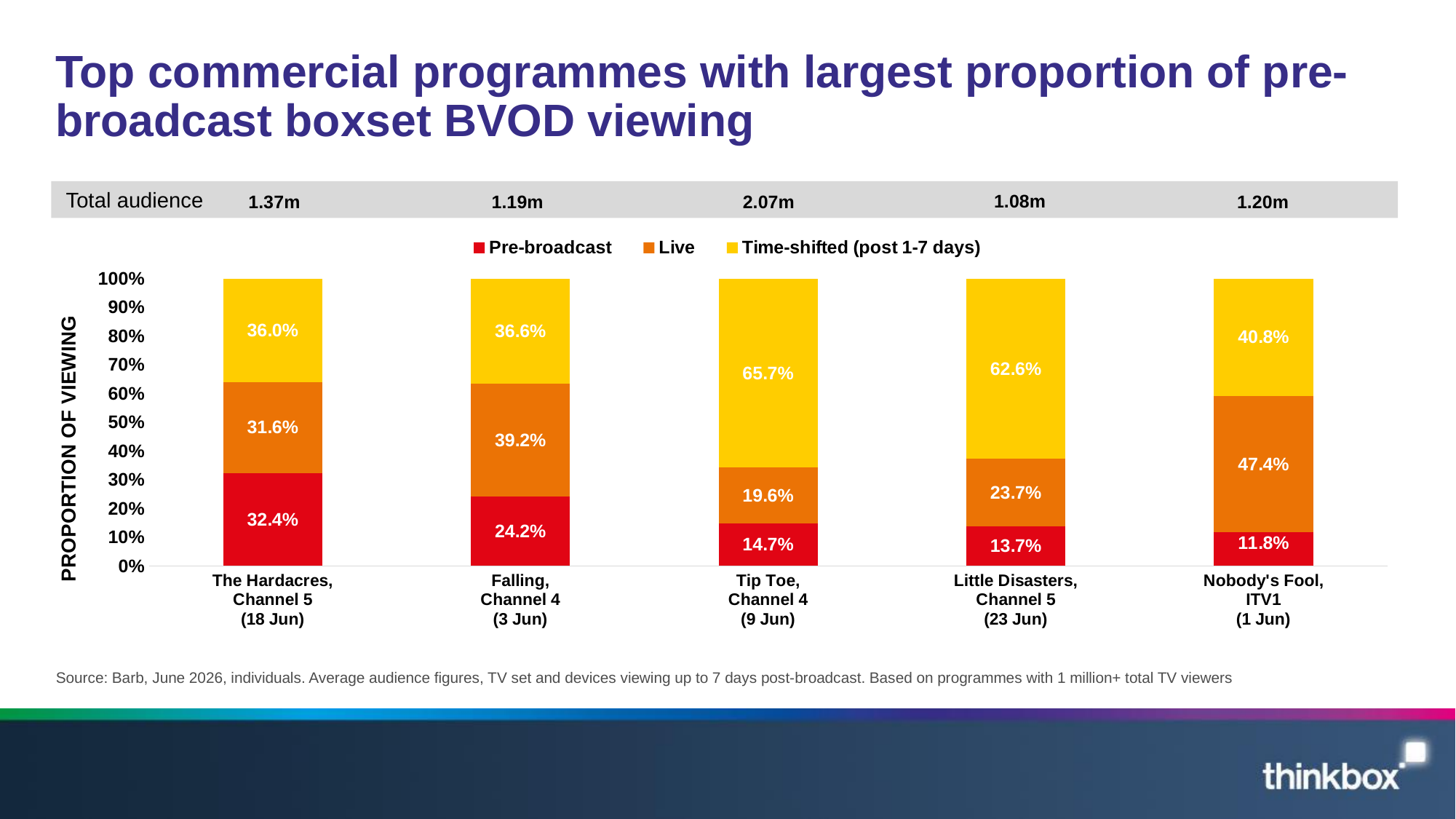
What is the difference between the Pre-broadcast shares of The Hardacres and Falling? 8.2% How many programmes are shown on the x axis? 5 What is the total audience shown for Tip Toe, Channel 4 (9 Jun)? 2.07m What is the Time-shifted (post 1-7 days) share of viewing for Tip Toe, Channel 4 (9 Jun)? 65.7% Which programme has the highest Live share of viewing? Nobody's Fool, ITV1 (1 Jun) What kind of chart is shown on the slide? Stacked bar chart Which programme has the lowest Pre-broadcast share of viewing? Nobody's Fool, ITV1 (1 Jun) How many series does the legend list? 3 Which is larger: the Time-shifted share for Tip Toe or for Little Disasters? Tip Toe What is the Live share of viewing for Nobody's Fool, ITV1 (1 Jun)? 47.4% What is the Pre-broadcast share of viewing for The Hardacres, Channel 5 (18 Jun)? 32.4% Which programme has the highest Pre-broadcast share of viewing? The Hardacres, Channel 5 (18 Jun)